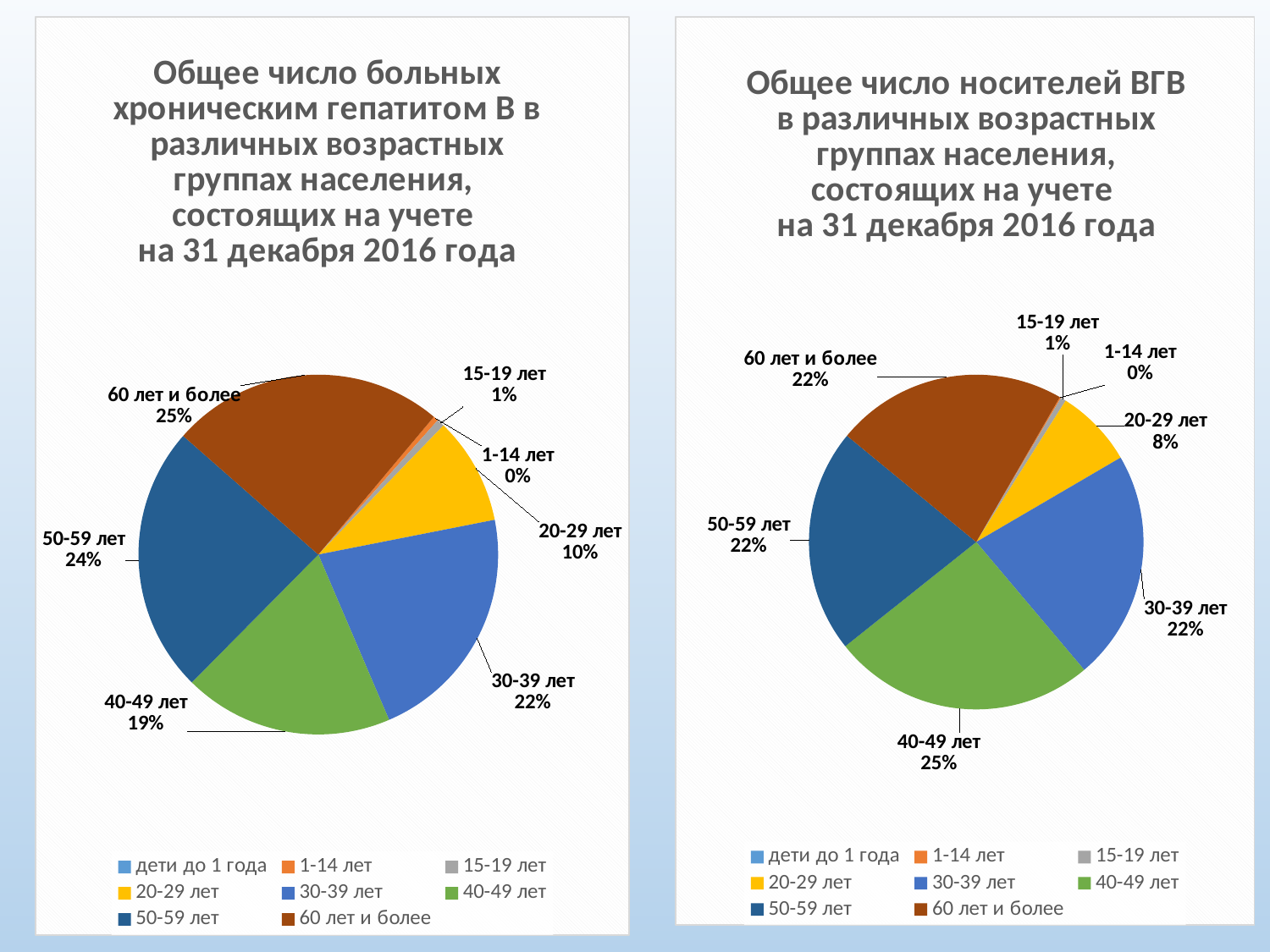
In the right chart (HBV carriers), what share of carriers are in the 20-29 лет age group? 8% In the right chart (HBV carriers), what share of carriers are in the 40-49 лет age group? 25% Which chart shows a larger share for the 60 лет и более group, the left chart or the right chart? the left chart In the left chart (chronic hepatitis B patients), which age group has the largest share? 60 лет и более What type of chart is used on the left side of the slide? pie chart In the left chart (chronic hepatitis B patients), what share of patients are in the 50-59 лет age group? 24% In the left chart (chronic hepatitis B patients), what is the difference in percentage points between the 30-39 лет and 40-49 лет groups? 3 How many age groups does the legend of the right chart (HBV carriers) list? 8 In the left chart (chronic hepatitis B patients), what share of patients are in the 20-29 лет age group? 10% In the right chart (HBV carriers), which age group has the largest share? 40-49 лет In the right chart (HBV carriers), what is the difference in percentage points between the 40-49 лет and 20-29 лет groups? 17 In the right chart (HBV carriers), which labelled age group has the smallest share? 1-14 лет